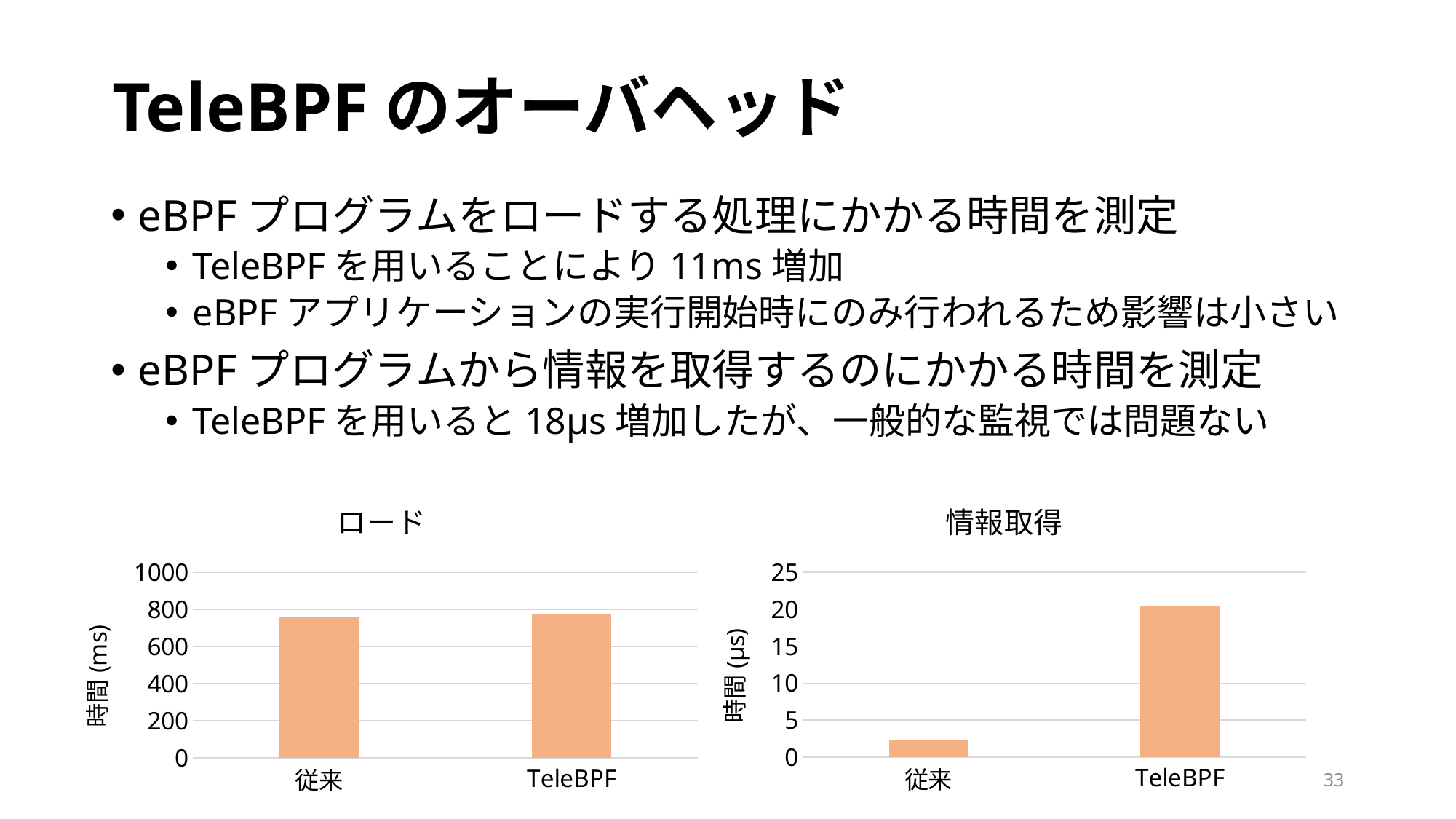
How many categories are shown in the ロード chart? 2 In the 情報取得 chart, is the value for TeleBPF greater or less than 15? greater What is the y-axis label of the ロード chart? 時間 (ms) In the 情報取得 chart, which category has the highest value? TeleBPF In the ロード chart, is the value for TeleBPF greater or less than 800? less In the ロード chart, is the value for 従来 greater or less than 600? greater In the 情報取得 chart, which category has the lowest value? 従来 In the 情報取得 chart, which is larger, the value for 従来 or the value for TeleBPF? TeleBPF What kind of chart is the ロード chart? bar chart How many categories are shown in the 情報取得 chart? 2 What kind of chart is the 情報取得 chart? bar chart